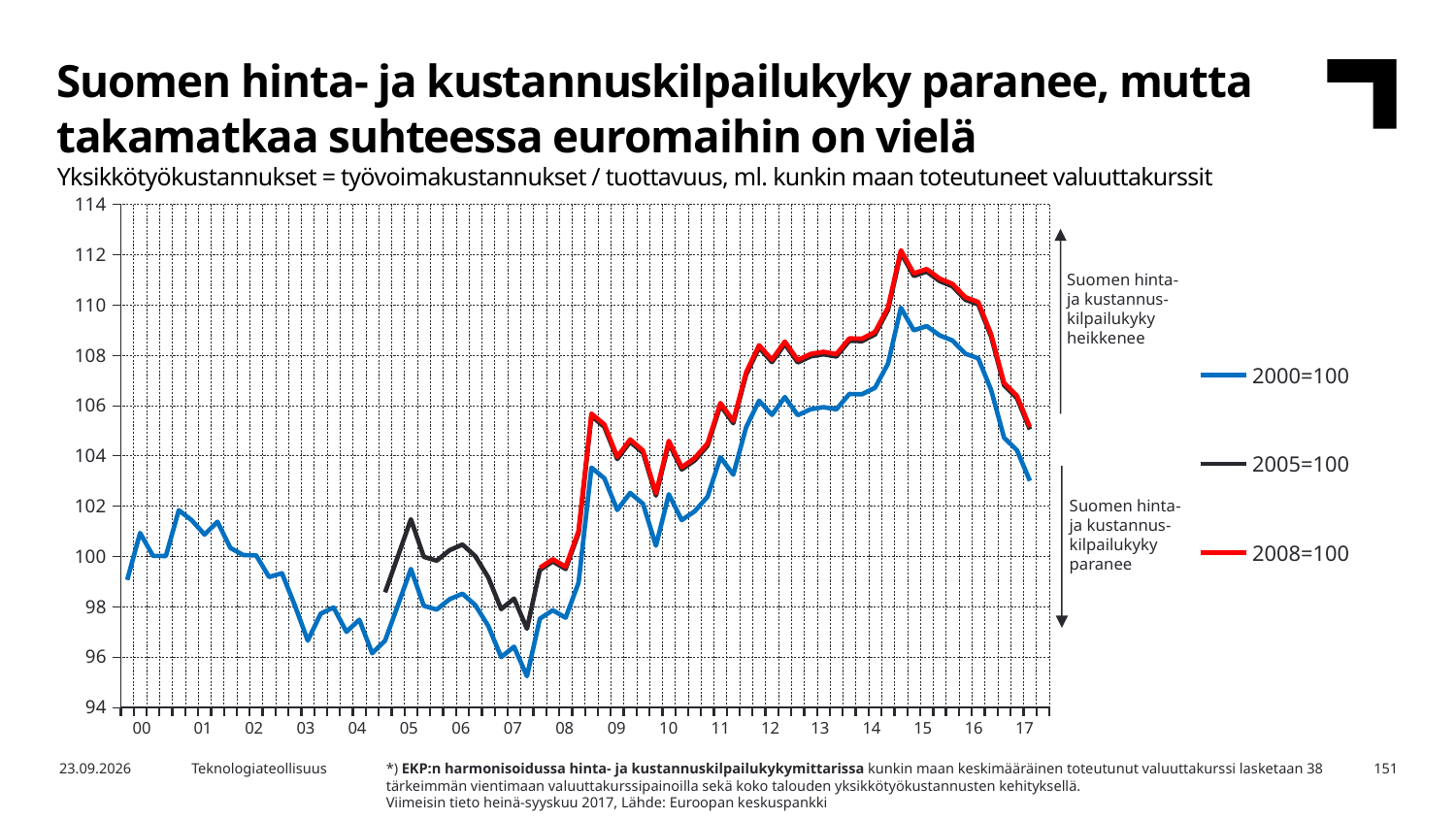
Is the lowest value of the 2000=100 series around 2007 greater or less than 98? less Around 2015, which series is higher: 2008=100 or 2000=100? 2008=100 Is the peak of the 2005=100 series in 2005 greater or less than 100? greater What are the three series listed in the legend? 2000=100, 2005=100, 2008=100 Which series reaches the highest value on the chart? 2008=100 Is the peak value of the 2000=100 series around 2015 greater or less than 108? greater How many series does the legend list? 3 What kind of chart is shown on the slide? line chart Do the values of the 2008=100 series rise or fall from 2015 to 2017? fall What colour is the 2008=100 line? red Which series reaches the lowest value on the chart? 2000=100